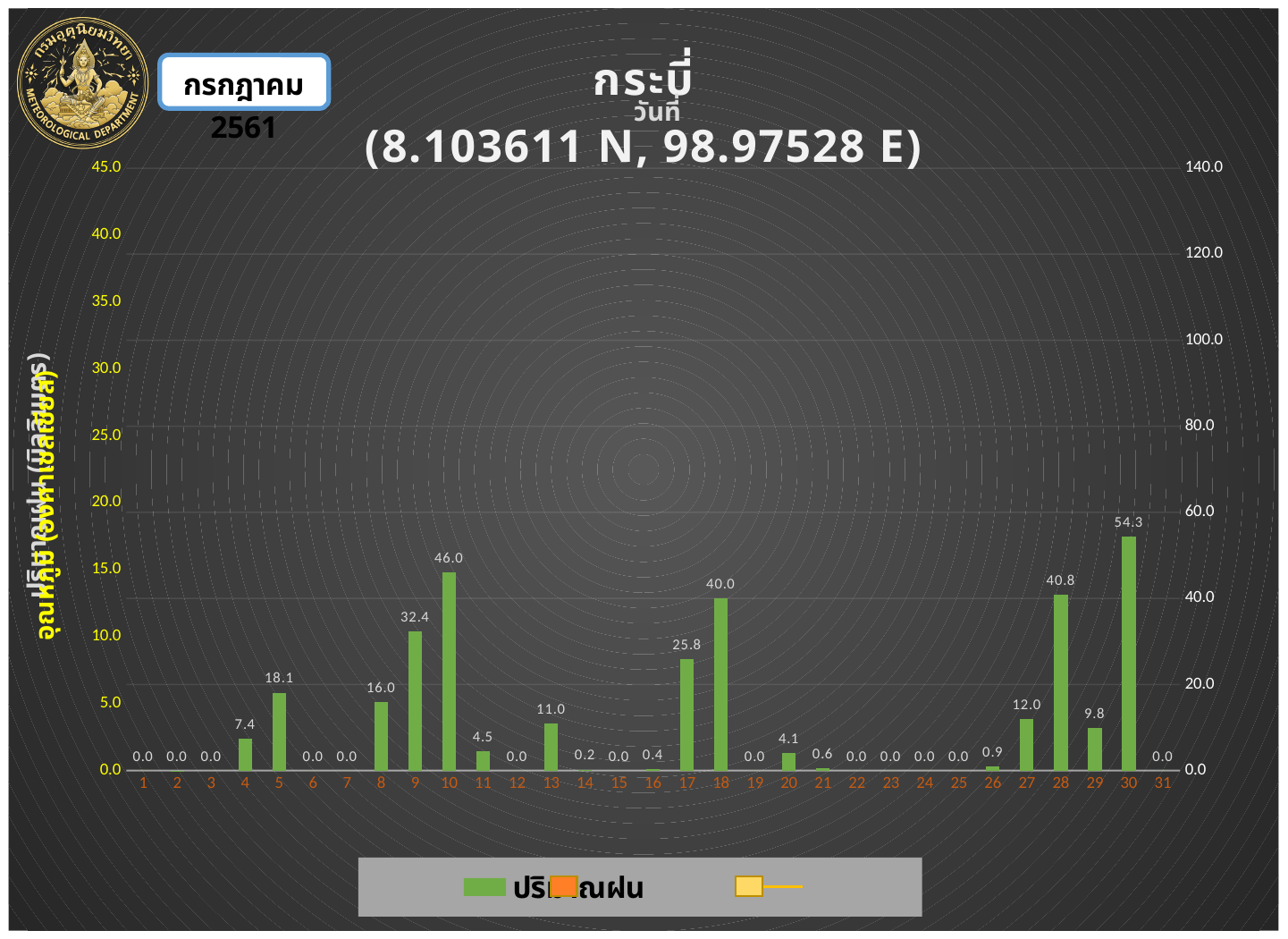
What is the value labelled on the bar for day 17? 25.8 What kind of chart is shown on the slide? bar chart What is the value labelled for day 14? 0.2 What is the rainfall value shown for day 30? 54.3 What is the highest tick value shown on the right-hand axis? 140.0 What is the rainfall value shown for day 10? 46.0 What is the difference between the values for day 30 and day 10? 8.3 How many days are shown along the x axis? 31 Is the value for day 30 greater or less than 40.0 on the right-hand axis? greater Which day has the highest rainfall value? 30 Which is larger, the value for day 9 or the value for day 17? day 9 What is the difference between the values for day 28 and day 18? 0.8